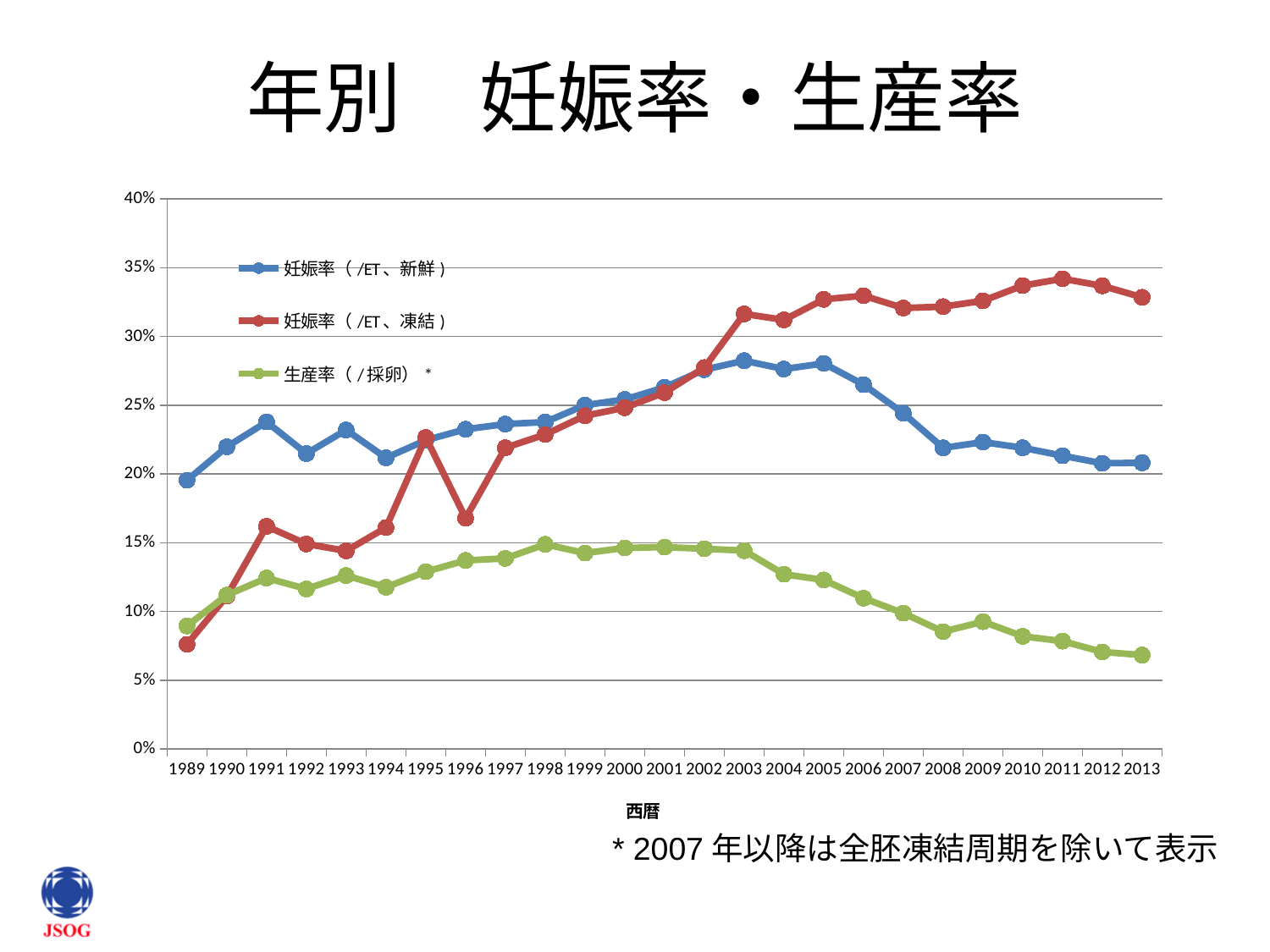
Does 生産率（/採卵）rise or fall from 2003 to 2013? fall Is the value for 生産率（/採卵）in 2013 greater or less than 10%? less How many years are plotted along the x axis? 25 In 2013, which is larger: 妊娠率（/ET、新鮮）or 妊娠率（/ET、凍結）? 妊娠率（/ET、凍結） Is the value for 妊娠率（/ET、新鮮）in 1989 greater or less than 20%? less What is the title of the chart? 年別 妊娠率・生産率 How many series does the legend list? 3 In which year is 妊娠率（/ET、凍結）at its lowest? 1989 In 1991, which is larger: 妊娠率（/ET、新鮮）or 妊娠率（/ET、凍結）? 妊娠率（/ET、新鮮） What kind of chart is shown on the slide? line chart Is the value for 妊娠率（/ET、凍結）in 1989 greater or less than 10%? less